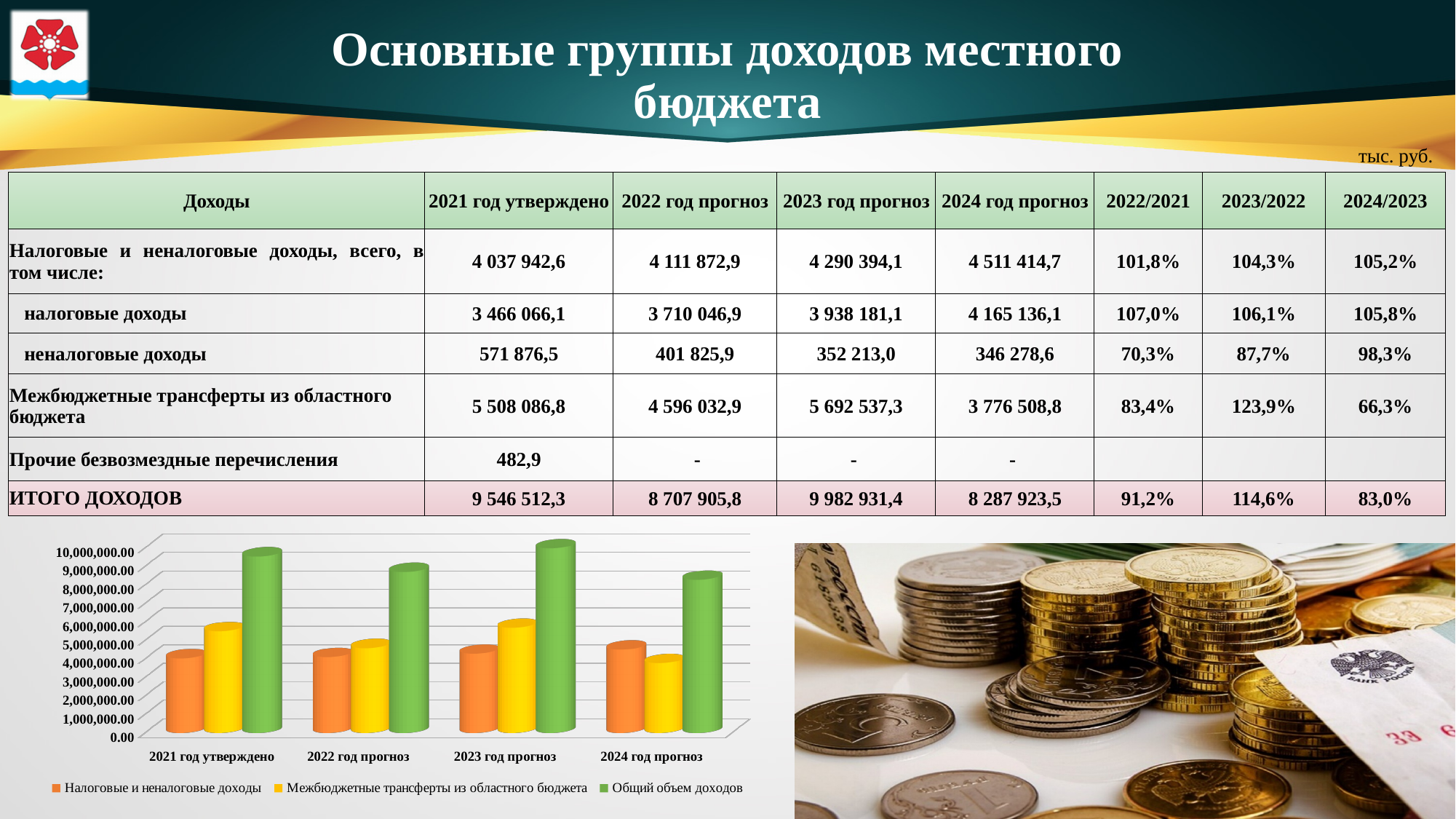
In the bar chart, in which year is the value for Общий объем доходов the highest? 2023 год прогноз In the bar chart, is the value for Общий объем доходов in 2021 год утверждено greater or less than 9,000,000.00? greater What colour are the bars for Общий объем доходов in the bar chart? green In the bar chart, in which year is the value for Общий объем доходов the lowest? 2024 год прогноз What kind of chart is shown at the bottom left of the slide? bar chart How many series does the legend of the bar chart list? 3 How many year categories are shown on the x axis of the bar chart? 4 In the bar chart, is the value for Межбюджетные трансферты из областного бюджета in 2024 год прогноз greater or less than 4,000,000.00? less In the bar chart, for 2024 год прогноз, which is larger: Налоговые и неналоговые доходы or Межбюджетные трансферты из областного бюджета? Налоговые и неналоговые доходы In the bar chart, for 2023 год прогноз, which is larger: Налоговые и неналоговые доходы or Межбюджетные трансферты из областного бюджета? Межбюджетные трансферты из областного бюджета In the bar chart, do the values for Налоговые и неналоговые доходы rise or fall from 2021 год утверждено to 2024 год прогноз? rise In the bar chart, in which year is the value for Межбюджетные трансферты из областного бюджета the lowest? 2024 год прогноз